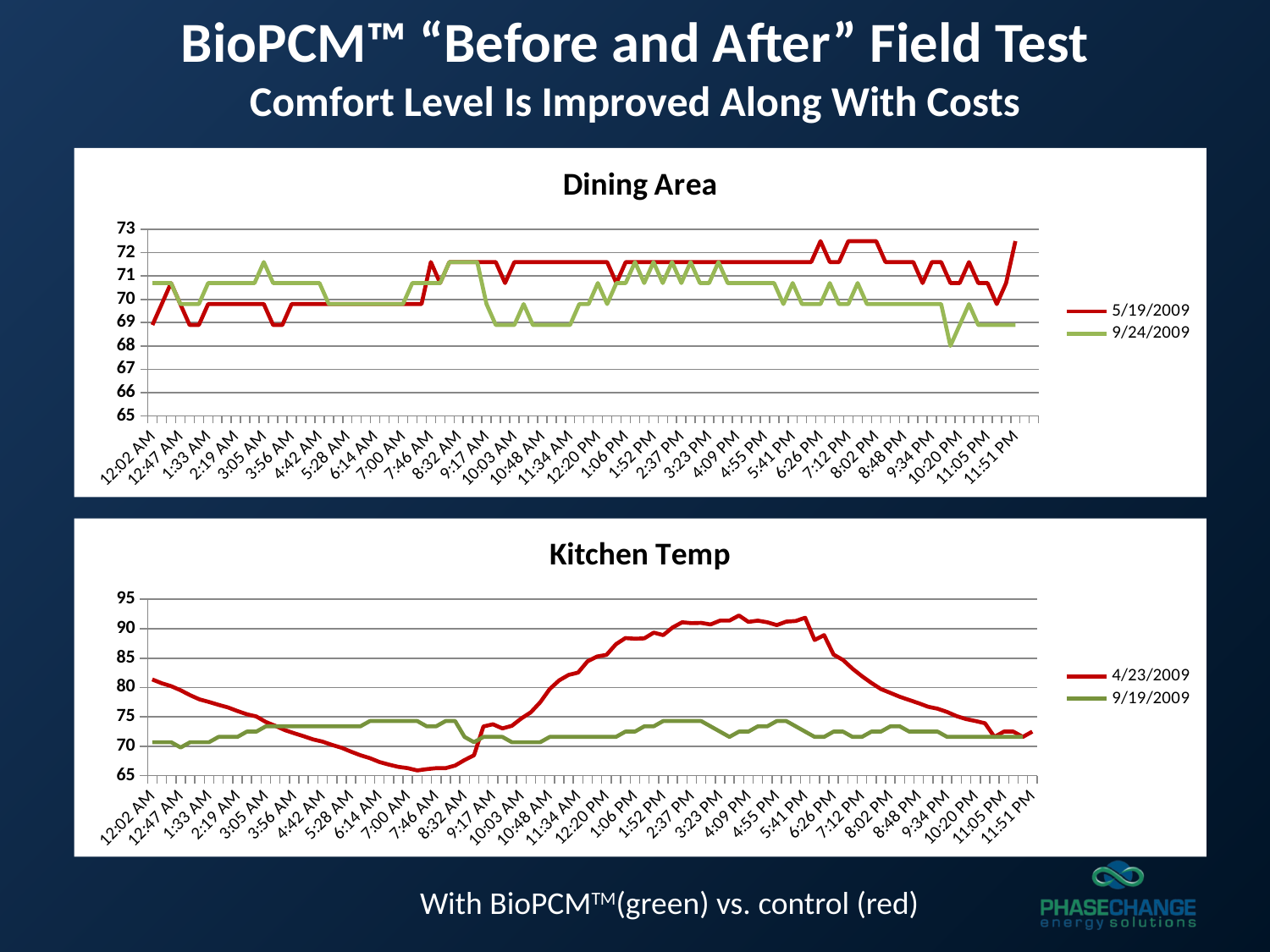
In the Kitchen Temp chart, is the value for 4/23/2009 at 7:00 AM greater or less than 70? less In the Dining Area chart, which series has the higher value at 10:03 AM? 5/19/2009 In the Kitchen Temp chart, which date is shown by the red line? 4/23/2009 In the Kitchen Temp chart, is the value for 9/19/2009 at 4:09 PM greater or less than 80? less How many series does the legend of the Kitchen Temp chart list? 2 In the Dining Area chart, is the value for 5/19/2009 at 7:12 PM greater or less than 71? greater In the Kitchen Temp chart, which series has the higher value at 2:37 PM? 4/23/2009 In the Kitchen Temp chart, does the 4/23/2009 line rise or fall between 12:02 AM and 7:00 AM? fall In the Kitchen Temp chart, which series reaches the highest value? 4/23/2009 In the Dining Area chart, which two dates are listed in the legend? 5/19/2009 and 9/24/2009 What kind of chart is the Dining Area chart? line chart